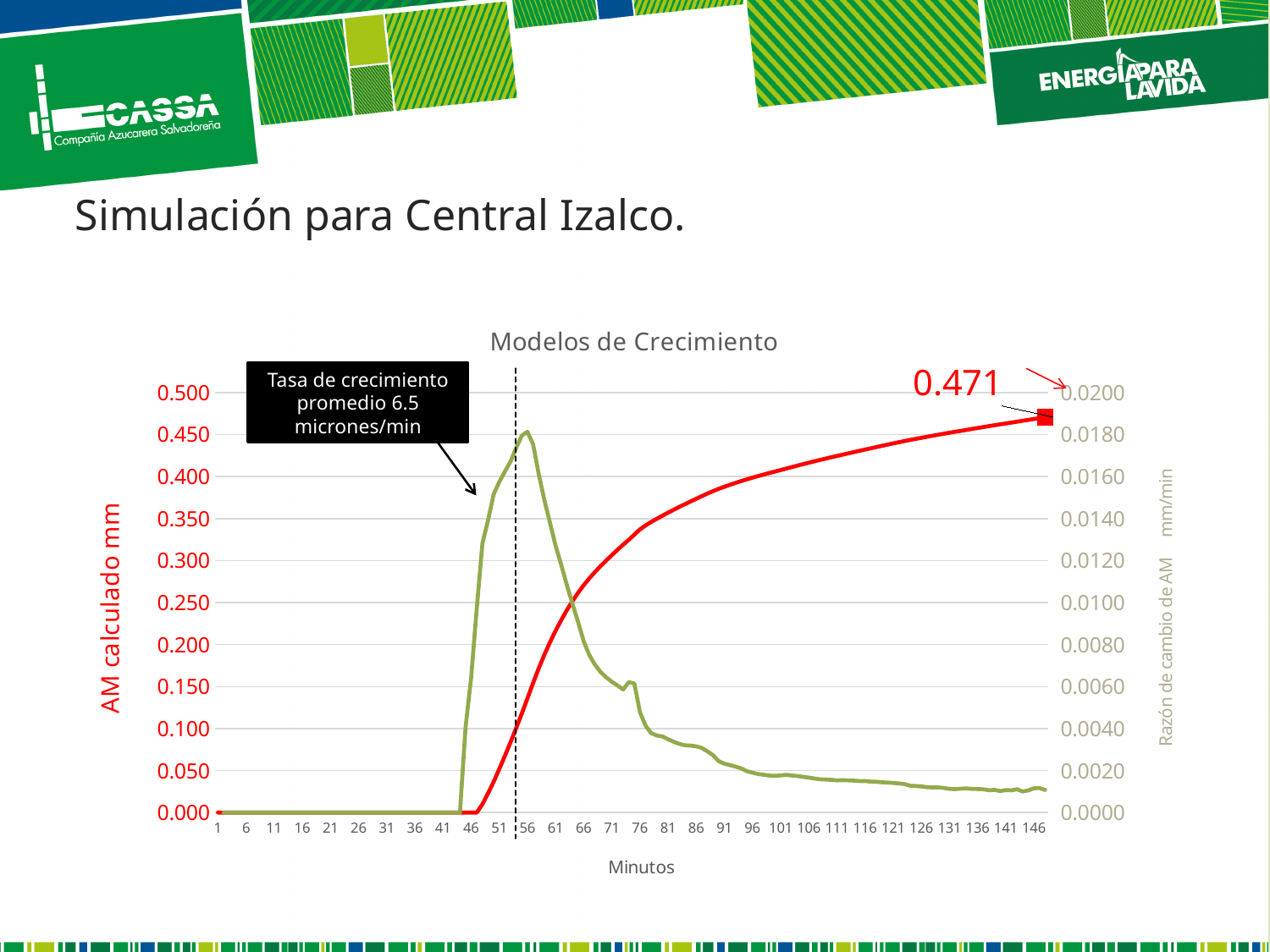
Is the value of the red AM calculado line at minute 41 greater or less than 0.050? less What kind of chart is shown on the slide? line chart Does the green Razón de cambio de AM line rise or fall between minute 56 and minute 146? fall What is the title of the chart? Modelos de Crecimiento According to the annotation box on the chart, what is the average growth rate (tasa de crecimiento promedio)? 6.5 micrones/min What value is labelled at the end of the red AM calculado line? 0.471 Which is larger for the red AM calculado line: the value at minute 96 or the value at minute 146? minute 146 Is the value of the green Razón de cambio de AM line at minute 146 greater or less than 0.0020? less Is the value of the red AM calculado line at minute 121 greater or less than 0.400? greater Does the red AM calculado line rise or fall between minute 46 and minute 146? rise